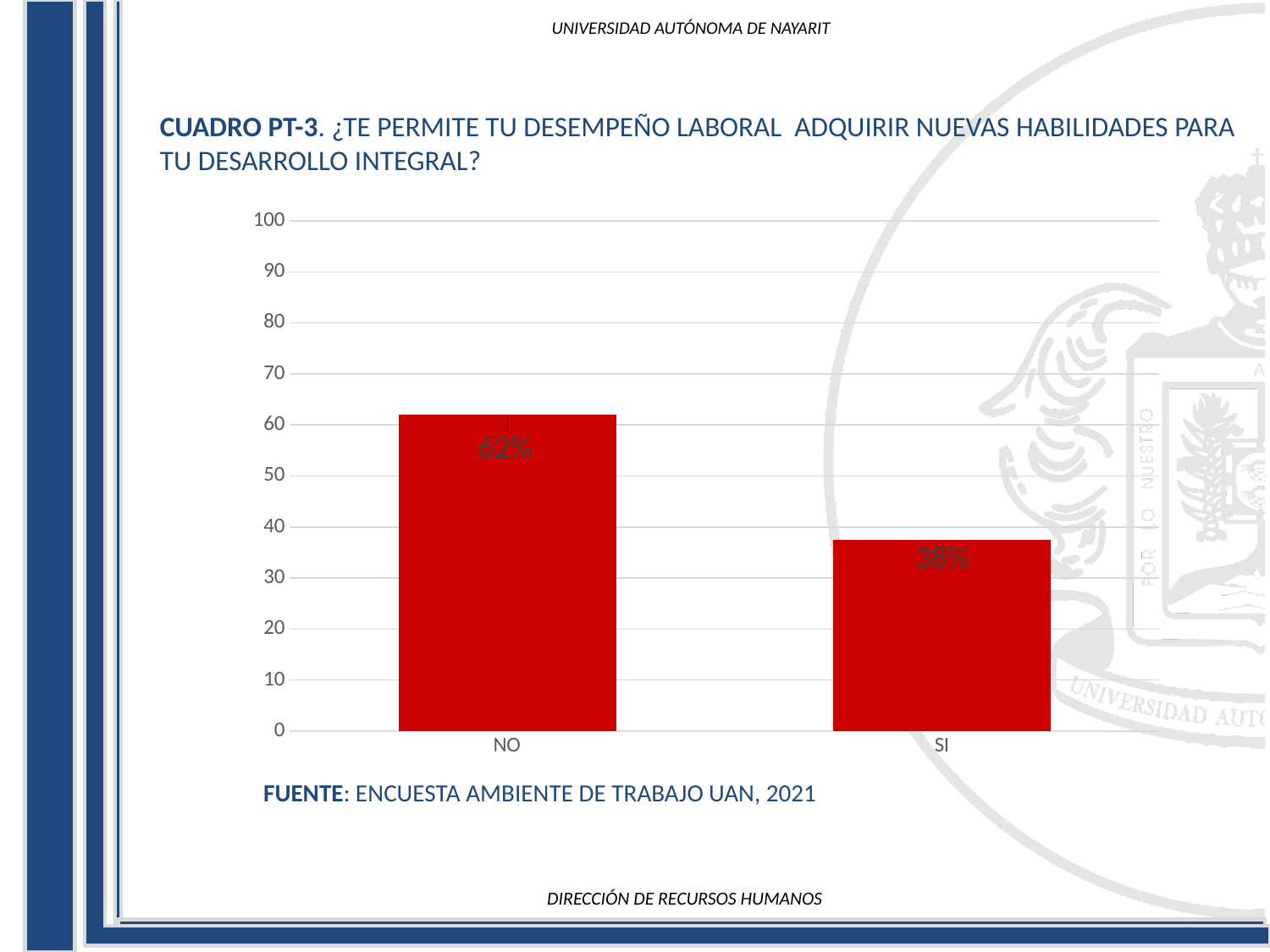
What is the highest value shown on the vertical axis? 100 What is the value for NO? 62% Which category has the lowest value? SI Is the value for NO greater or less than 50? greater What colour are the bars in the chart? red Which category has the highest value? NO How many categories are shown on the x axis? 2 Is the value for SI greater or less than 40? less Which is larger, the value for NO or the value for SI? NO What is the difference between the values for NO and SI? 24% What kind of chart is shown on the slide? bar chart What is the value for SI? 38%